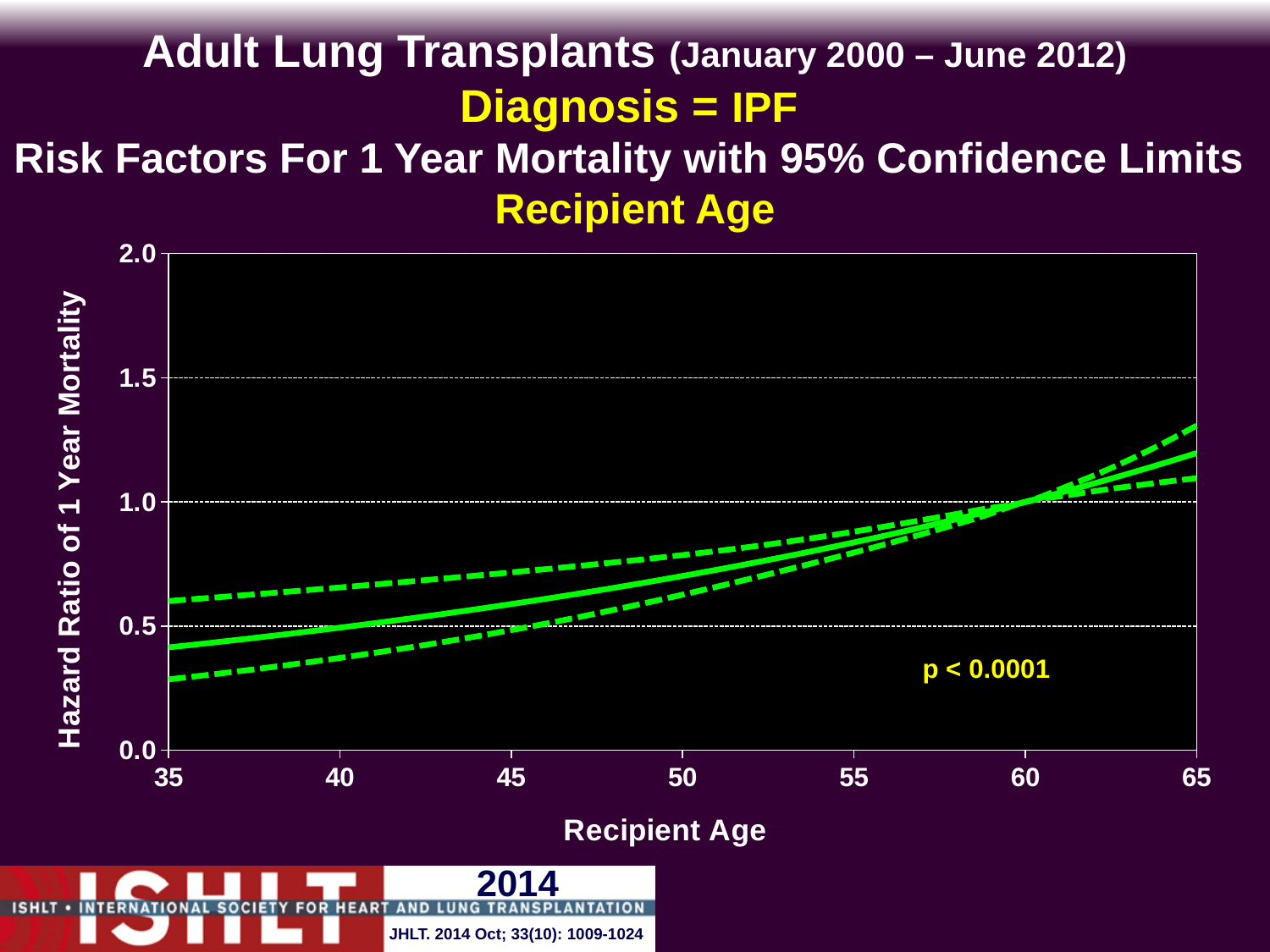
How many lines are plotted on the chart? 3 Is the hazard ratio (solid line) at recipient age 65 greater or less than 1.0? greater What p-value is printed on the chart? p < 0.0001 Which is larger, the hazard ratio at recipient age 35 or at recipient age 65? recipient age 65 What kind of chart is shown on the slide? line chart Is the hazard ratio (solid line) at recipient age 50 greater or less than 1.0? less Is the upper 95% confidence limit (upper dashed line) at recipient age 35 greater or less than 0.5? greater What is the highest value shown on the y axis? 2.0 What is the label of the y axis? Hazard Ratio of 1 Year Mortality Does the hazard ratio of 1 year mortality rise or fall as recipient age increases from 35 to 65? rise